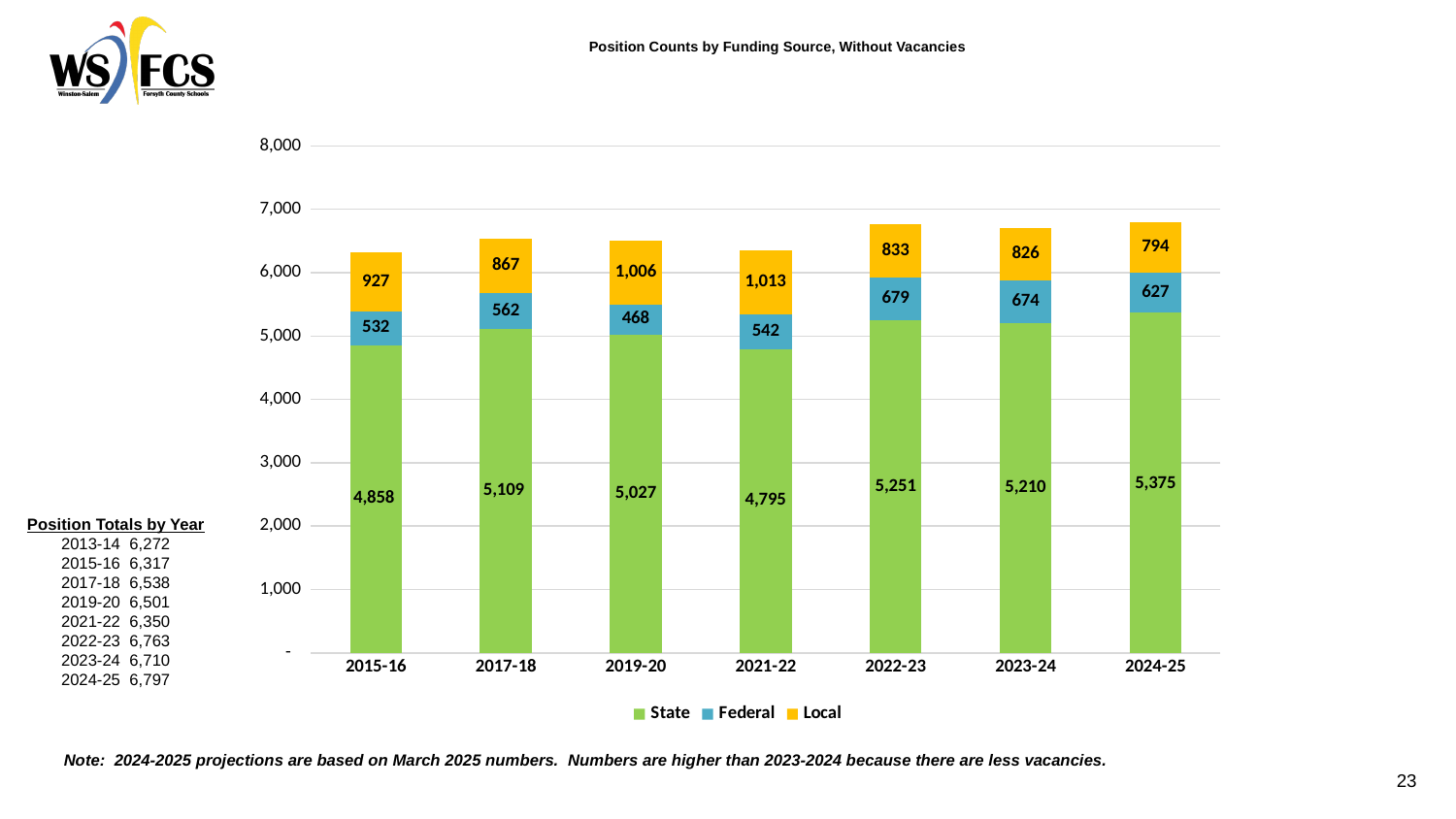
Which is larger, the State position count for 2017-18 or for 2019-20? 2017-18 What is the State position count for 2024-25? 5,375 How many years are shown on the x axis? 7 How many series does the legend list? 3 What kind of chart is shown on the slide? Stacked bar chart What is the Federal position count for 2019-20? 468 What is the title of the chart? Position Counts by Funding Source, Without Vacancies What is the total position count for the 2022-23 stacked bar? 6,763 Which year has the highest State position count? 2024-25 What is the Local position count for 2021-22? 1,013 Which year has the lowest Federal position count? 2019-20 What is the difference between the Local position counts for 2015-16 and 2017-18? 60